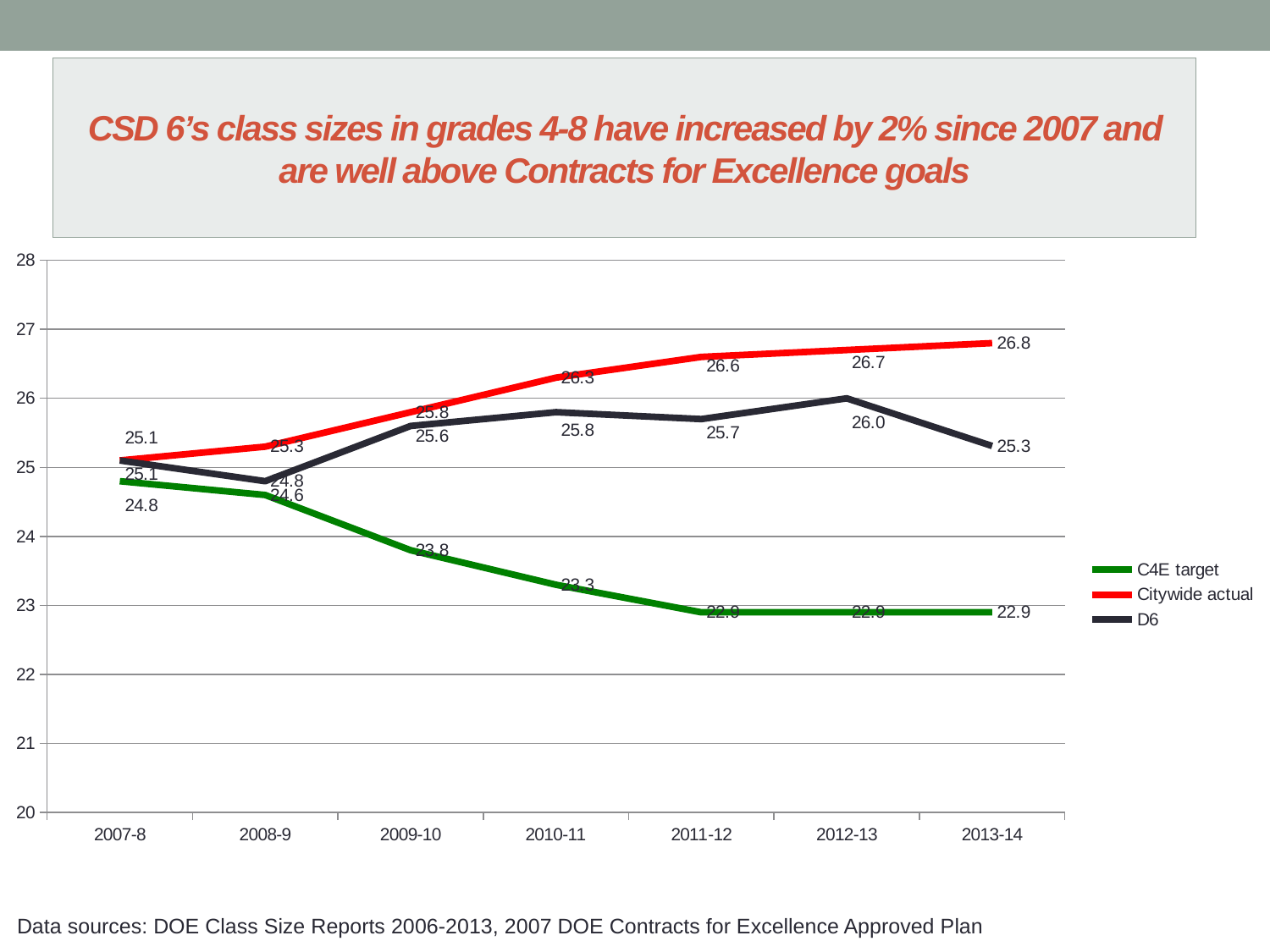
What is the difference between the Citywide actual and D6 values in 2013-14? 1.5 How many school years are shown on the x axis? 7 What is the C4E target value for 2013-14? 22.9 Does the C4E target line rise or fall from 2007-8 to 2013-14? Fall What kind of chart is shown on the slide? Line chart In which year is the Citywide actual value highest? 2013-14 In which year is the D6 value highest? 2012-13 How many series does the legend list? 3 What is the D6 value for 2013-14? 25.3 What is the Citywide actual value for 2013-14? 26.8 What is the D6 value for 2011-12? 25.7 Which is larger in 2012-13, the Citywide actual value or the D6 value? Citywide actual